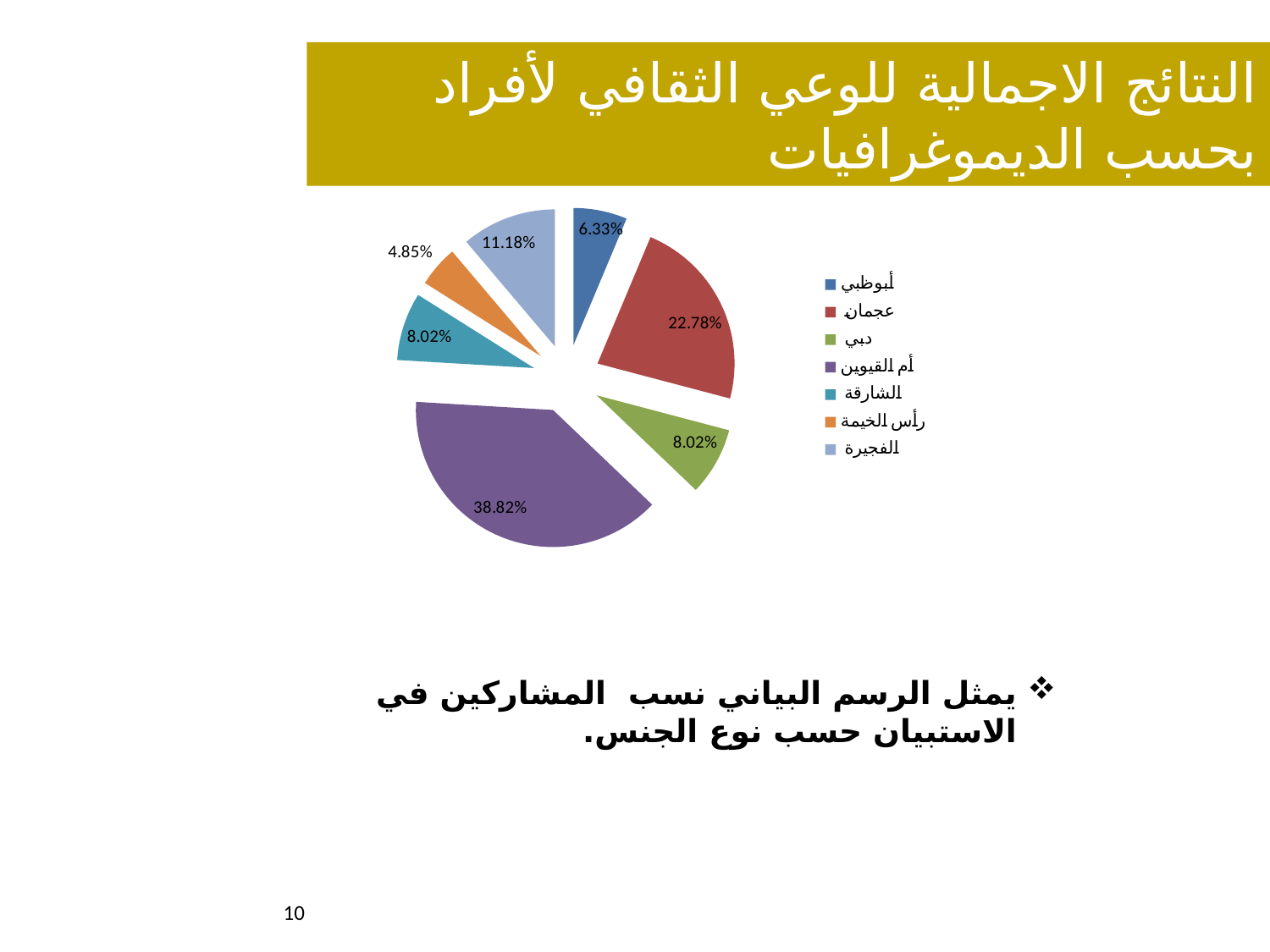
What type of chart is shown on the slide? pie chart Which is larger, the value for الفجيرة or the value for أبوظبي? الفجيرة Which legend entry is shown in purple? أم القيوين What is the value shown for أم القيوين? 38.82% What is the value shown for الفجيرة? 11.18% Which category has the largest slice of the pie? أم القيوين What is the value shown for رأس الخيمة? 4.85% How many slices does the pie chart have? 7 What is the value shown for عجمان? 22.78% Which category has the smallest slice of the pie? رأس الخيمة What is the value shown for أبوظبي? 6.33% What is the difference between the values for أم القيوين and عجمان? 16.04%